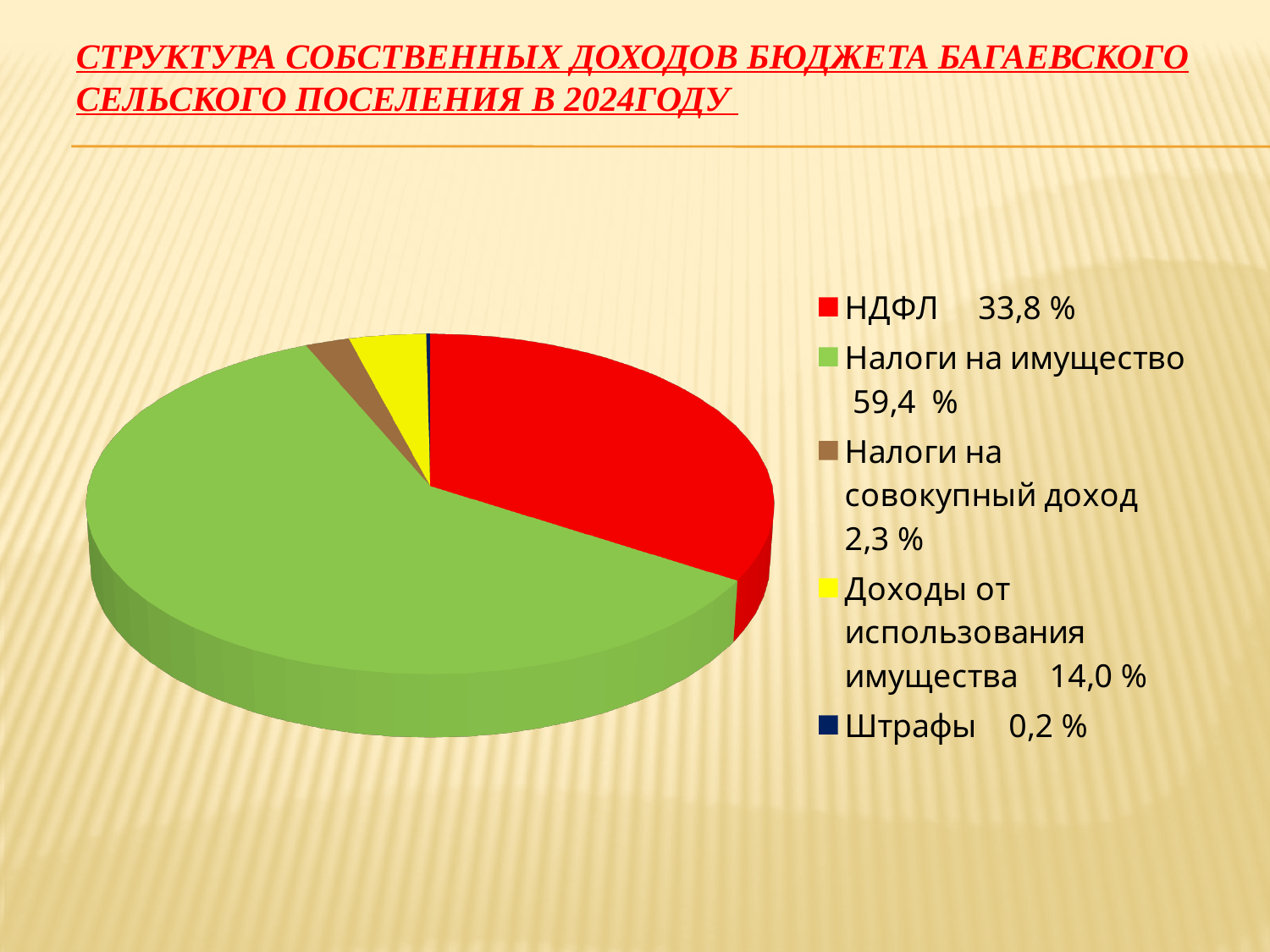
What percentage is shown for НДФЛ in the legend? 33,8 % How many categories does the legend of the pie chart list? 5 Which category has the largest share of the pie? Налоги на имущество Which is larger, the share for НДФЛ or the share for Налоги на имущество? Налоги на имущество What percentage is shown for Доходы от использования имущества in the legend? 14,0 % Which category has the smallest share of the pie? Штрафы What is the difference in percentage points between Налоги на имущество and НДФЛ according to the legend values? 25,6 What percentage is shown for Налоги на совокупный доход in the legend? 2,3 % What colour represents НДФЛ in the pie chart? red What kind of chart is shown on the slide? pie chart What percentage is shown for Налоги на имущество in the legend? 59,4 % What percentage is shown for Штрафы in the legend? 0,2 %